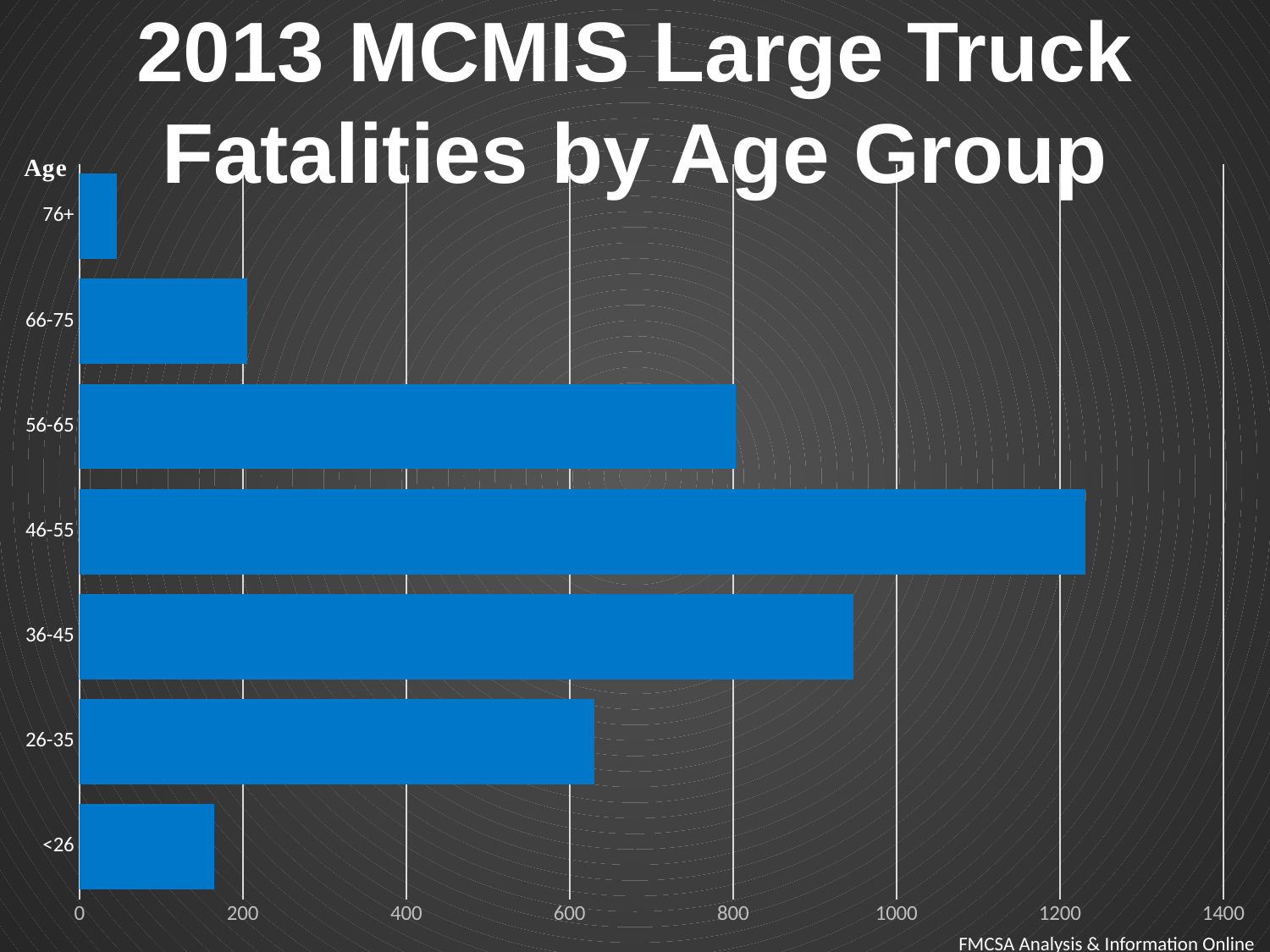
How many age groups are plotted in the chart? 7 What source is credited at the bottom of the slide? FMCSA Analysis & Information Online Which age group has more fatalities, 56-65 or 66-75? 56-65 What kind of chart is shown on the slide? bar chart Is the value for the 46-55 age group greater or less than 1200? greater Which age group has the highest number of large truck fatalities? 46-55 Which age group has the lowest number of large truck fatalities? 76+ Is the value for the <26 age group greater or less than 200? less Is the value for the 26-35 age group greater or less than 600? greater What is the title of the chart? 2013 MCMIS Large Truck Fatalities by Age Group Which age group has more fatalities, 36-45 or 26-35? 36-45